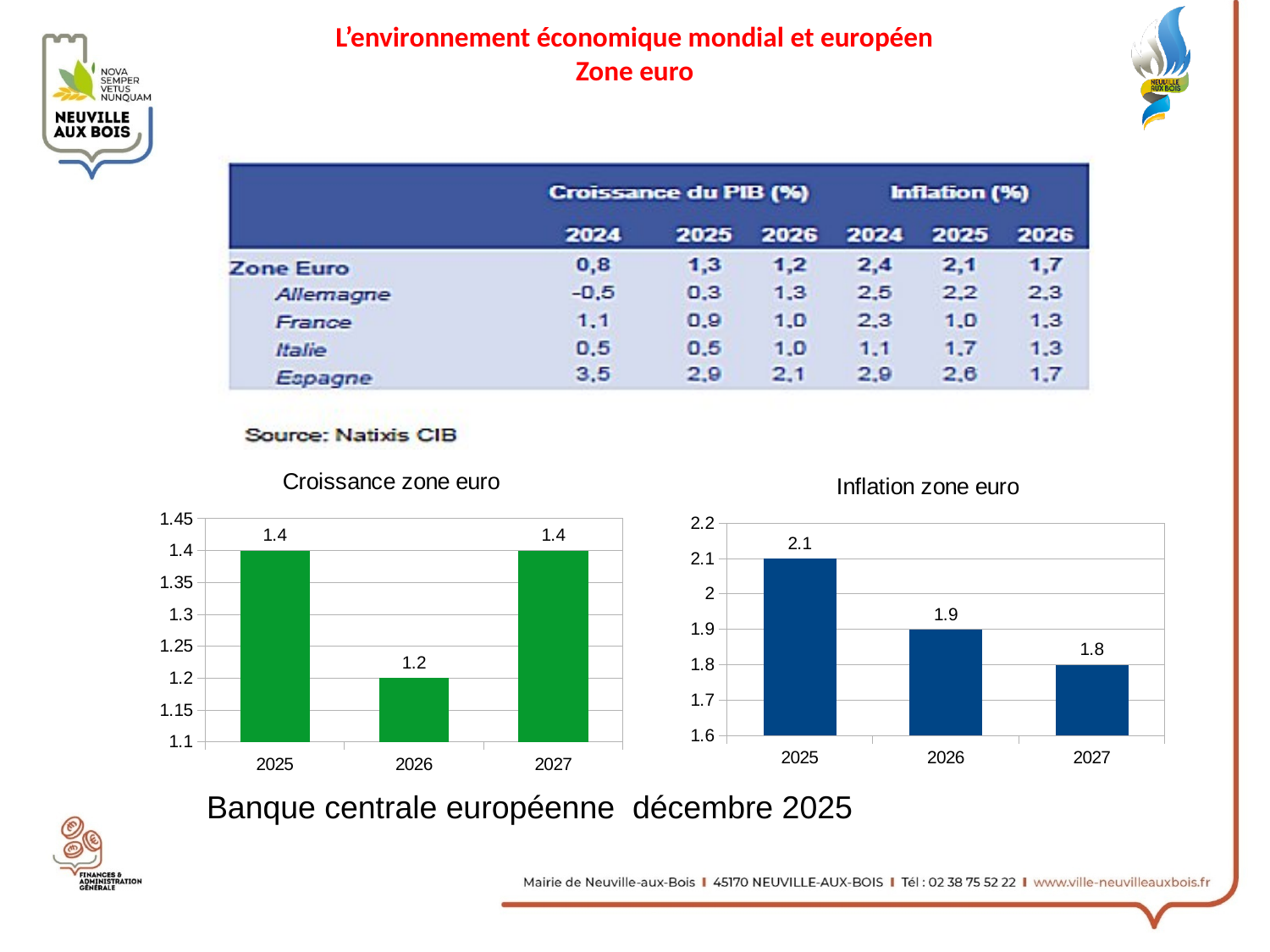
In the 'Inflation zone euro' chart, what is the difference between the values for 2025 and 2027? 0.3 In the 'Croissance zone euro' chart, what is the difference between the values for 2025 and 2026? 0.2 In the 'Croissance zone euro' chart, what is the value for 2026? 1.2 In the 'Inflation zone euro' chart, do the values rise or fall from 2025 to 2027? fall How many years are shown on the x axis of the 'Croissance zone euro' chart? 3 In the 'Inflation zone euro' chart, what is the value for 2027? 1.8 In the 'Inflation zone euro' chart, which year has the lowest value? 2027 In the 'Inflation zone euro' chart, what is the value for 2025? 2.1 In the 'Inflation zone euro' chart, which year has the highest value? 2025 In the 'Croissance zone euro' chart, which year has the lowest value? 2026 What kind of chart is the 'Inflation zone euro' chart? bar chart In the 'Inflation zone euro' chart, which is larger, the value for 2026 or the value for 2027? 2026